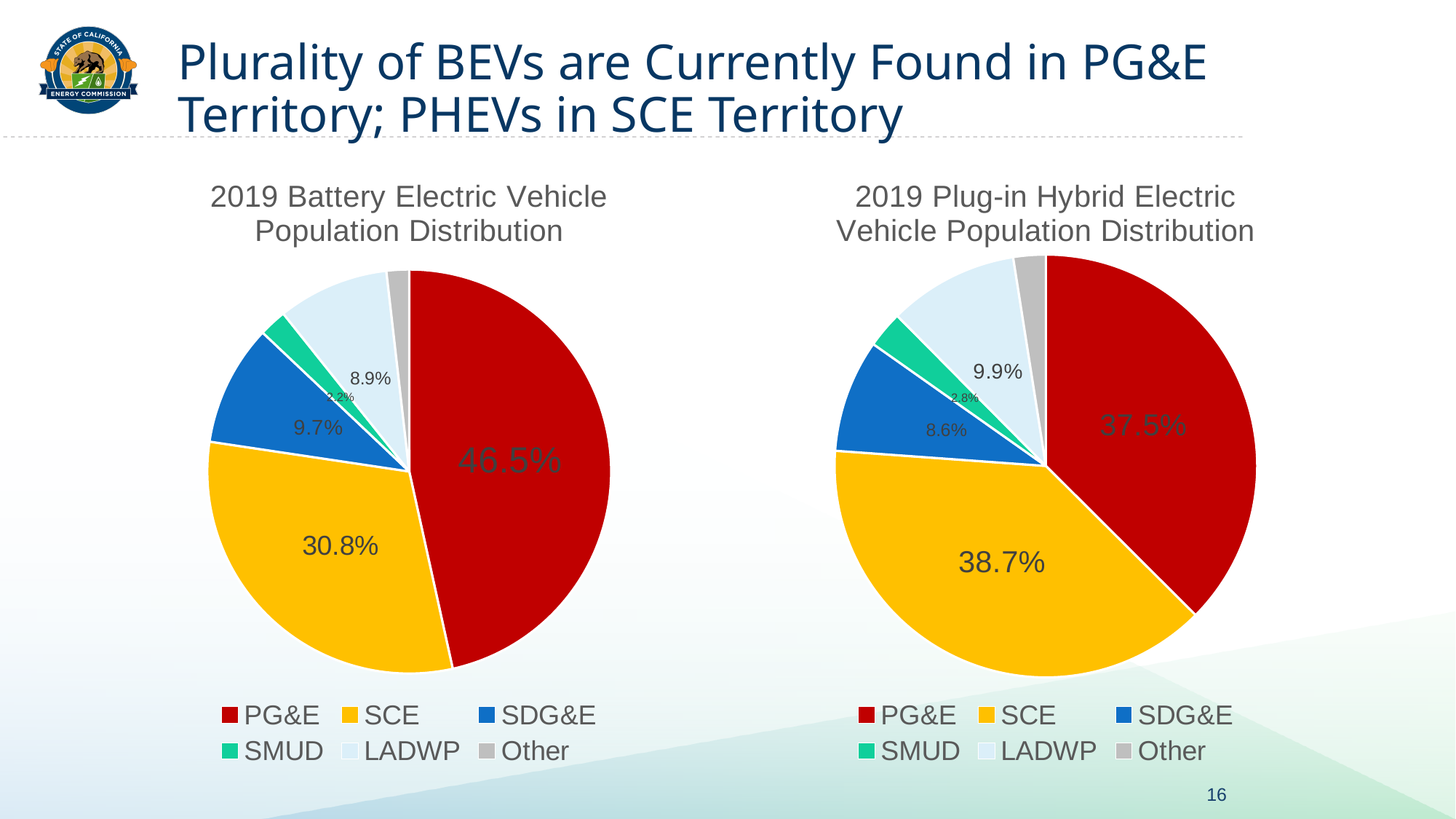
In the 2019 Plug-in Hybrid Electric Vehicle Population Distribution chart, what is the value for PG&E? 37.5% In the 2019 Plug-in Hybrid Electric Vehicle Population Distribution chart, which utility has the largest share? SCE How many categories does the legend of the 2019 Battery Electric Vehicle Population Distribution chart list? 6 In the 2019 Battery Electric Vehicle Population Distribution chart, what is the difference between the PG&E and SCE shares? 15.7% In the 2019 Battery Electric Vehicle Population Distribution chart, which utility has the largest share? PG&E What kind of chart is the 2019 Plug-in Hybrid Electric Vehicle Population Distribution chart? Pie chart In the 2019 Plug-in Hybrid Electric Vehicle Population Distribution chart, what share of the pie is SCE? 38.7% In the 2019 Battery Electric Vehicle Population Distribution chart, what is the value for SDG&E? 9.7% In the 2019 Battery Electric Vehicle Population Distribution chart, what is the value for SCE? 30.8% In the 2019 Battery Electric Vehicle Population Distribution chart, what share of the pie is PG&E? 46.5% In the 2019 Battery Electric Vehicle Population Distribution chart, what is the value for LADWP? 8.9% In the 2019 Plug-in Hybrid Electric Vehicle Population Distribution chart, what is the value for LADWP? 9.9%